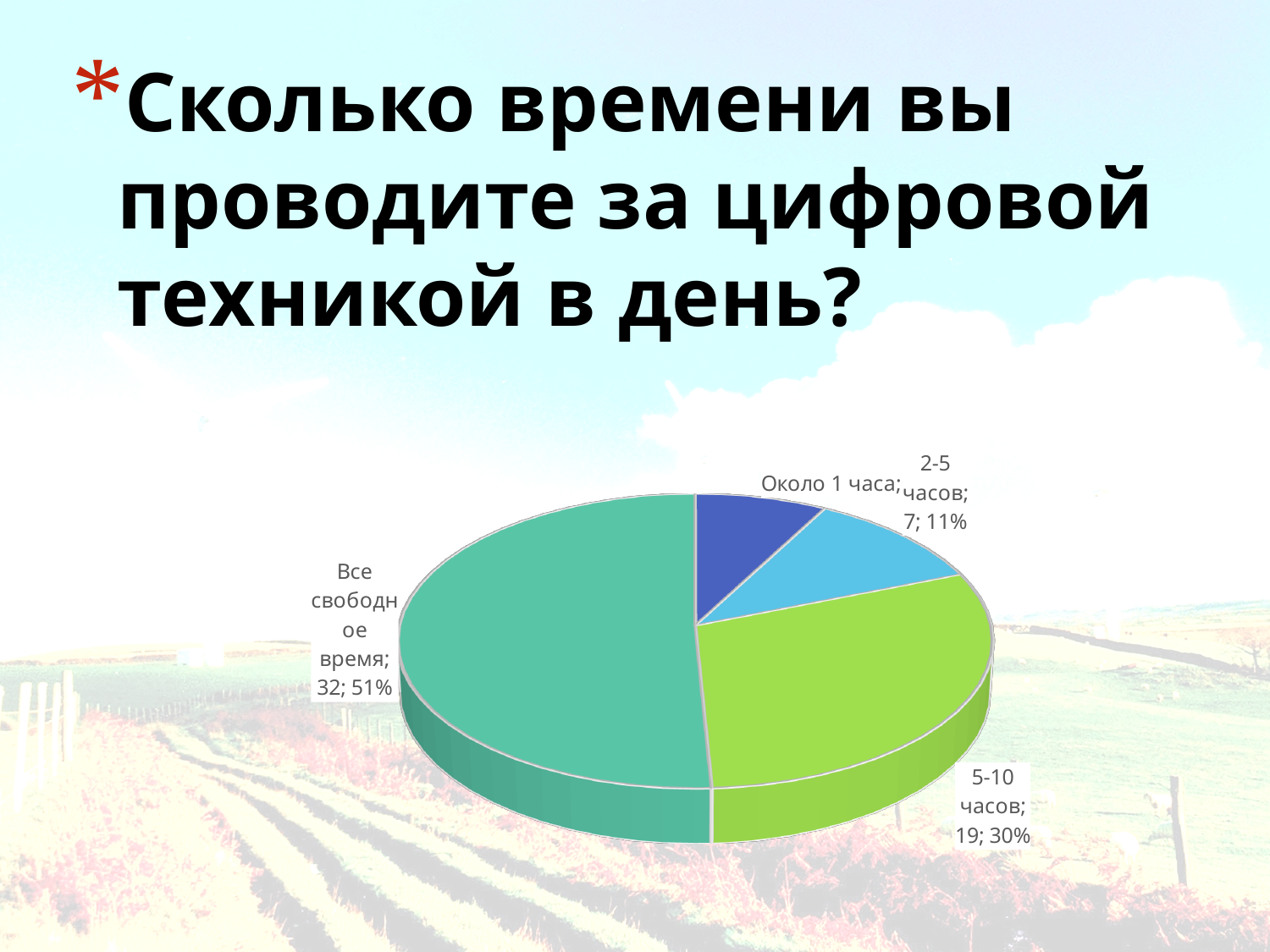
Which slice of the pie chart is the largest? Все свободное время What is the value for the slice "2-5 часов"? 7 What is the difference between the values for "Все свободное время" and "5-10 часов"? 13 What question is the chart on the slide answering, according to the slide title? Сколько времени вы проводите за цифровой техникой в день? What share of the pie does the slice "5-10 часов" represent? 30% What share of the pie does the slice "2-5 часов" represent? 11% Which is larger: the value for "5-10 часов" or the value for "2-5 часов"? 5-10 часов What kind of chart is shown on the slide? pie chart What share of the pie does the slice "Все свободное время" represent? 51% What is the value for the slice "Все свободное время"? 32 What is the value for the slice "5-10 часов"? 19 How many slices does the pie chart have? 4